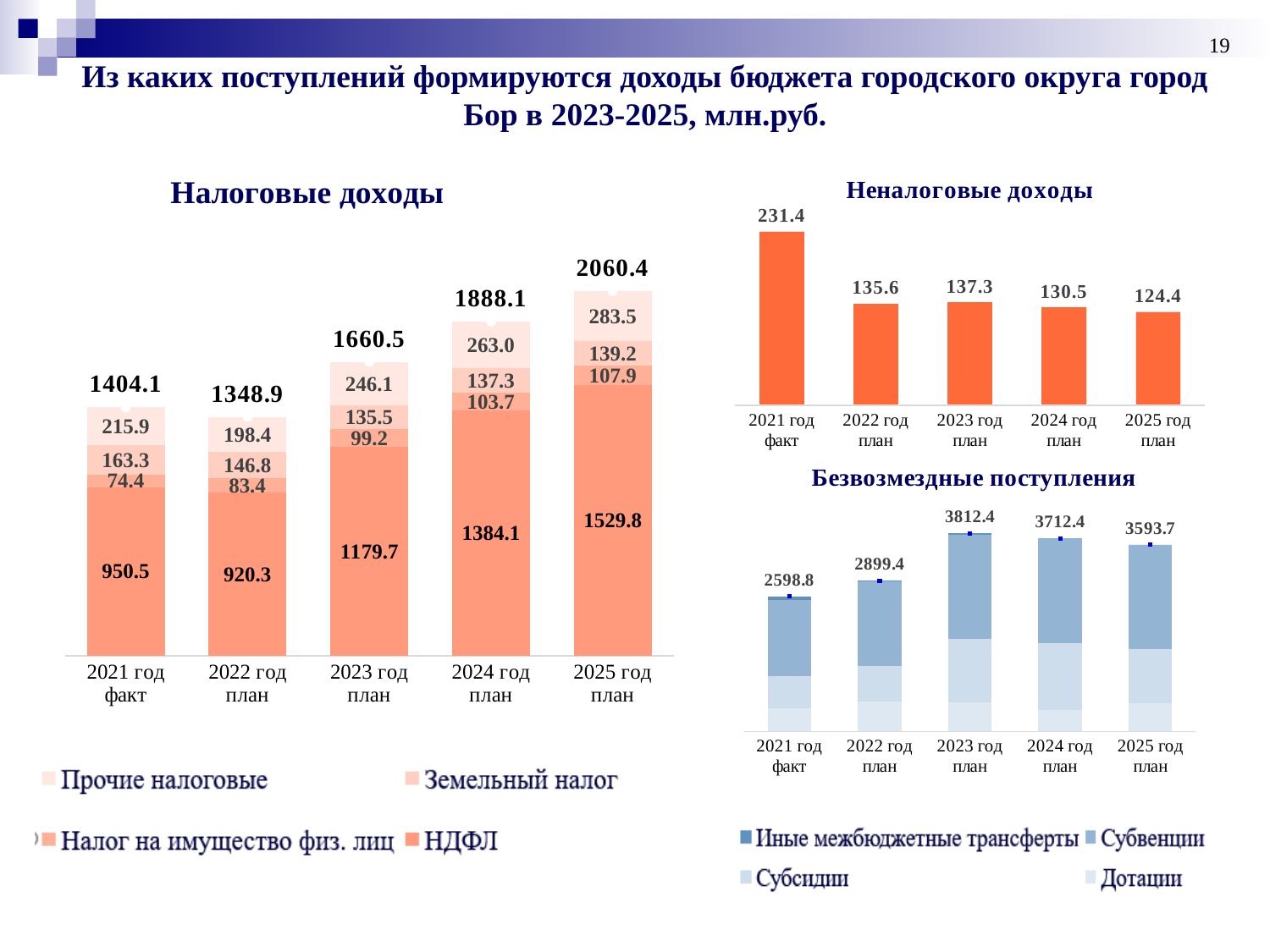
In the 'Налоговые доходы' chart, what is the total of the stacked bar for 2025 год план? 2060.4 In the 'Налоговые доходы' chart, what is the value of Земельный налог for 2021 год факт? 163.3 In the 'Налоговые доходы' chart, do the bar totals rise or fall from 2022 год план to 2025 год план? rise In the 'Безвозмездные поступления' chart, which is larger: the total for 2023 год план or for 2024 год план? 2023 год план In the 'Налоговые доходы' chart, what is the value of НДФЛ for 2024 год план? 1384.1 In the 'Неналоговые доходы' chart, which year has the highest value? 2021 год факт How many categories are shown on the x axis of the 'Неналоговые доходы' chart? 5 In the 'Неналоговые доходы' chart, which year has the lowest value? 2025 год план In the 'Безвозмездные поступления' chart, what is the difference between the totals for 2023 год план and 2022 год план? 913.0 What kind of chart is the 'Неналоговые доходы' chart? bar chart In the 'Неналоговые доходы' chart, what is the difference between the values for 2021 год факт and 2022 год план? 95.8 How many series does the legend of the 'Безвозмездные поступления' chart list? 4